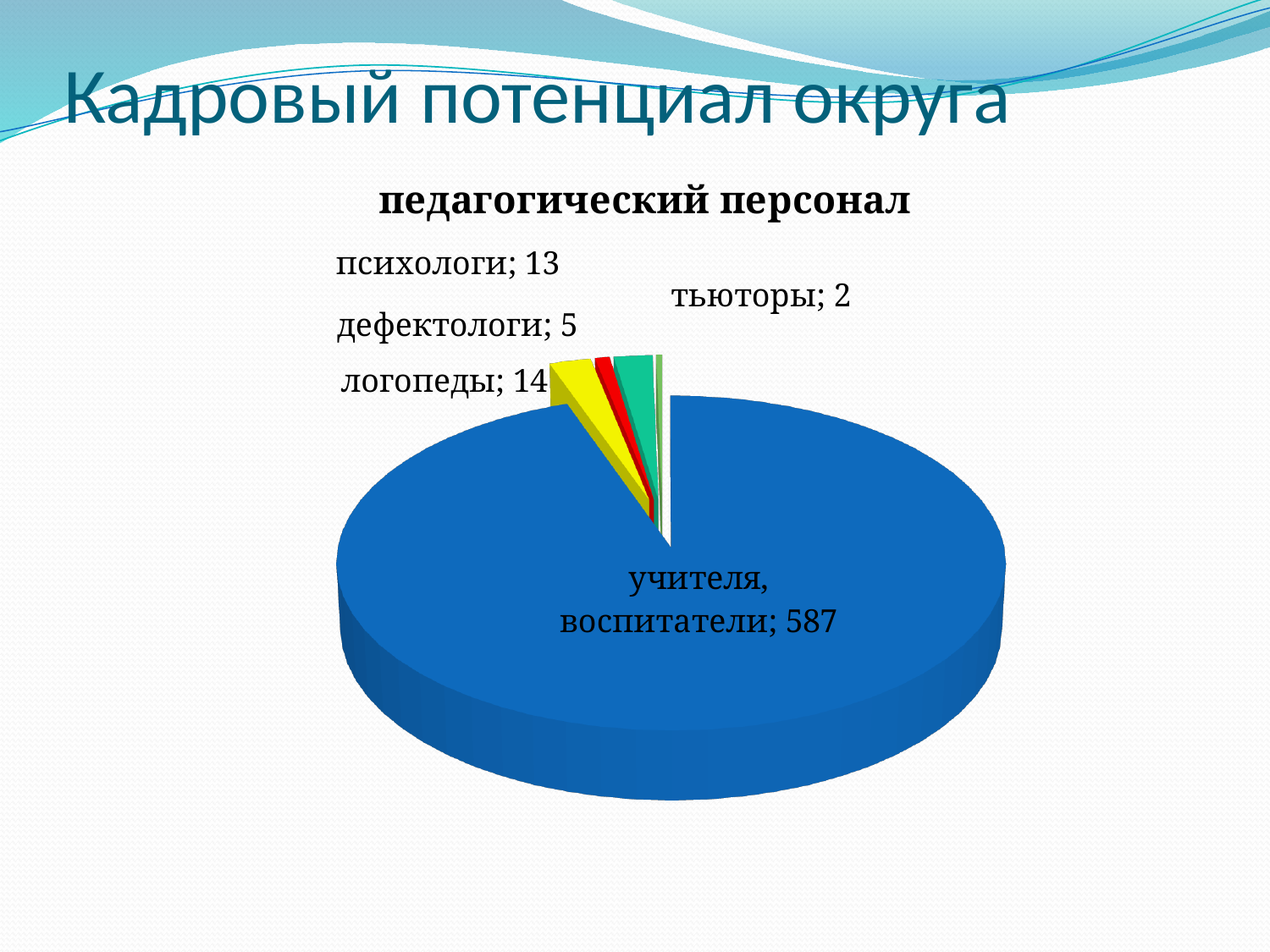
What is the value for психологи? 13 What is the title of the chart? педагогический персонал Which is larger, the value for дефектологи or the value for тьюторы? дефектологи What is the value for логопеды? 14 What is the value for учителя, воспитатели? 587 How many categories does the pie chart show? 5 What is the difference between the values for логопеды and дефектологи? 9 What is the value for тьюторы? 2 Which category has the smallest value? тьюторы What kind of chart is shown on the slide? pie chart What is the total of all the values shown in the pie chart? 621 Which category has the largest slice of the pie? учителя, воспитатели